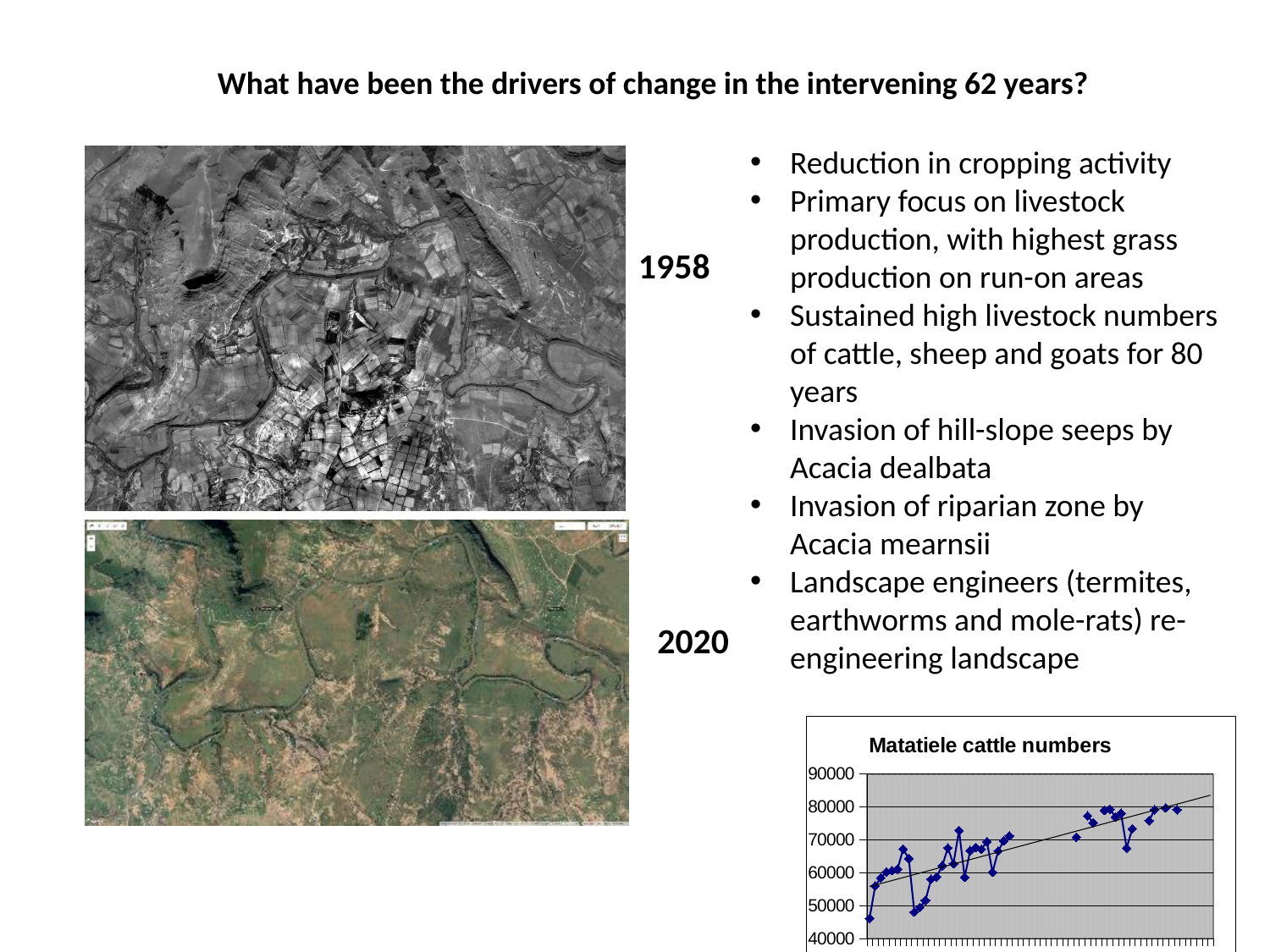
In the Matatiele cattle numbers chart, is the lowest plotted value greater or less than 40000? greater In the Matatiele cattle numbers chart, is the highest plotted value greater or less than 90000? less In the Matatiele cattle numbers chart, is the first plotted value greater or less than 50000? less What kind of chart is the Matatiele cattle numbers chart? line chart In the Matatiele cattle numbers chart, do the values generally rise or fall along the x axis? rise What is the highest tick value shown on the y axis of the Matatiele cattle numbers chart? 90000 What is the title of the chart on the slide? Matatiele cattle numbers In the Matatiele cattle numbers chart, is the last plotted value larger or smaller than the first plotted value? larger